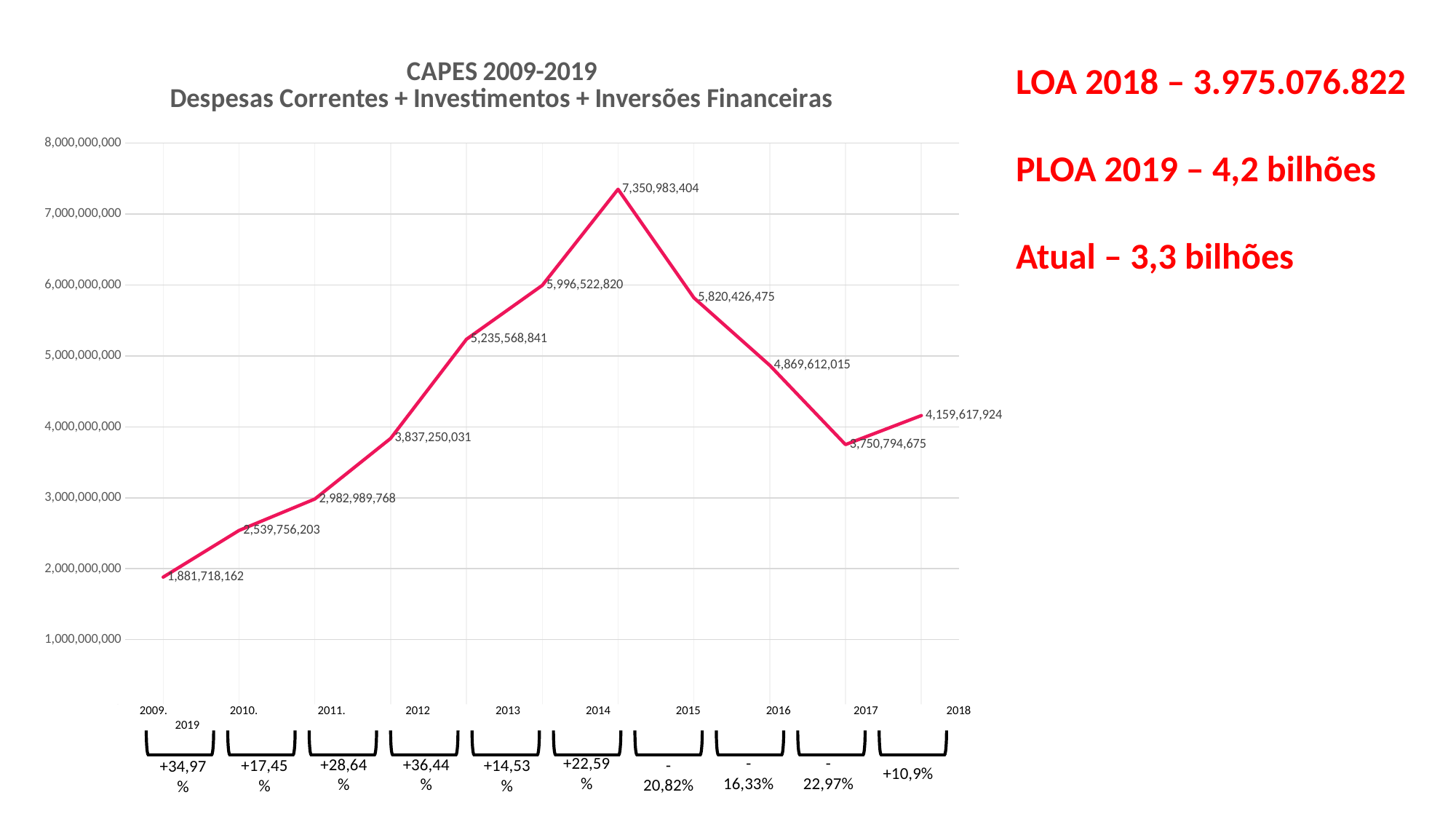
What is the difference between the last plotted value (4,159,617,924) and the value 3,750,794,675 just before it? 408,823,249 Is the peak value of the line greater or less than 7,000,000,000? greater What percentage change is shown under the last bracket below the x axis? +10,9% How many data points are plotted on the line? 11 What is the lowest value plotted on the line? 1,881,718,162 What percentage change is shown under the first bracket below the x axis? +34,97% What is the difference between the highest plotted value and the lowest plotted value? 5,469,265,242 From the peak of the line to the point labelled 3,750,794,675, does the line rise or fall? fall What kind of chart is shown on the slide? line chart Which is larger, the first plotted value (1,881,718,162) or the last plotted value (4,159,617,924)? 4,159,617,924 What is the highest value plotted on the line? 7,350,983,404 What is the title of the chart? CAPES 2009-2019 Despesas Correntes + Investimentos + Inversões Financeiras